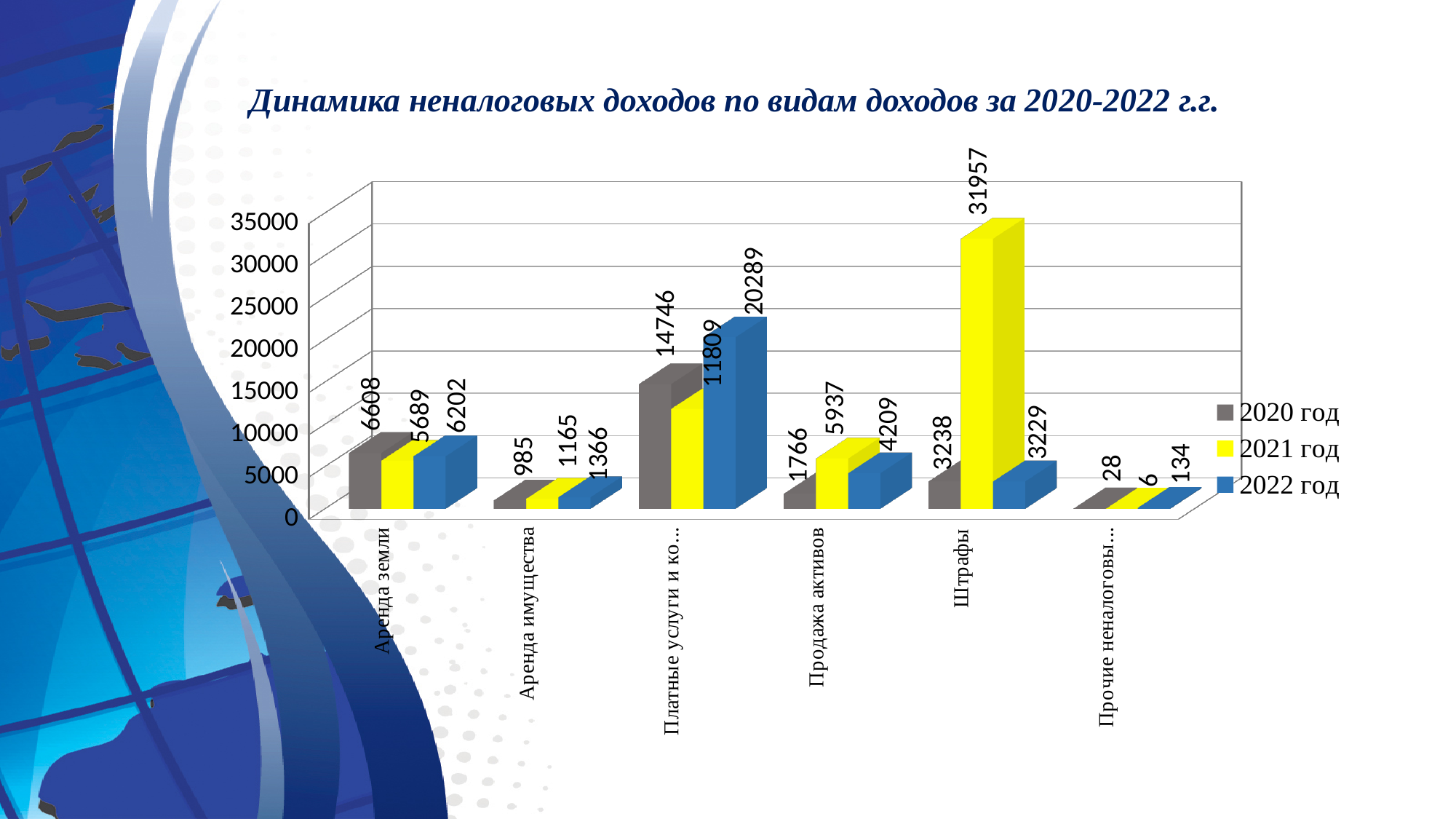
What is the value for Аренда земли in the 2020 год series? 6608 What is the value for Аренда имущества in the 2021 год series? 1165 Which category has the highest value in the 2021 год series? Штрафы How many series does the legend list? 3 What kind of chart is shown on the slide? bar chart What is the difference between the 2022 год and 2020 год values for Аренда имущества? 381 What is the value for Штрафы in the 2021 год series? 31957 Which category has the lowest value in the 2022 год series? Прочие неналоговы... How many categories are shown on the x axis? 6 What is the value for Продажа активов in the 2022 год series? 4209 What colour represents the 2021 год series in the legend? yellow Which is larger for Продажа активов: the 2021 год value or the 2022 год value? 2021 год